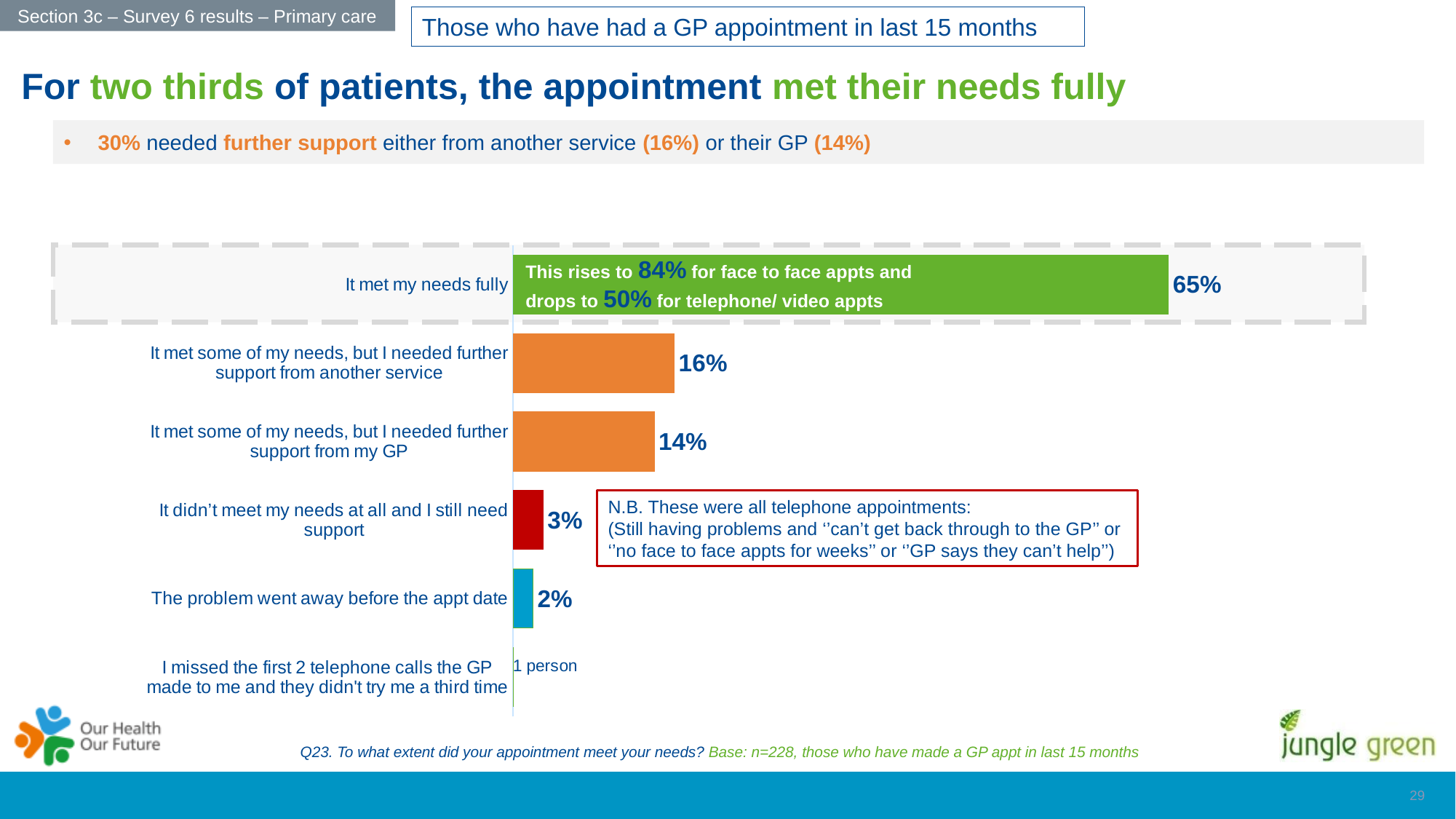
What percentage said it met some of their needs but they needed further support from their GP? 14% What percentage of patients said the appointment met their needs fully? 65% What percentage said the problem went away before the appointment date? 2% How many response categories are shown in the chart? 6 What colour is the bar for 'It didn't meet my needs at all and I still need support'? Red Which response category has the highest value? It met my needs fully What is the label shown for the category 'I missed the first 2 telephone calls the GP made to me and they didn't try me a third time'? 1 person What type of chart is shown on the slide? Bar chart What percentage said the appointment didn't meet their needs at all and they still need support? 3% What is the difference between the share who needed further support from another service and the share who needed further support from their GP? 2% Which is larger: the share who said the problem went away before the appointment date, or the share who said it didn't meet their needs at all? It didn't meet my needs at all and I still need support What percentage said it met some of their needs but they needed further support from another service? 16%